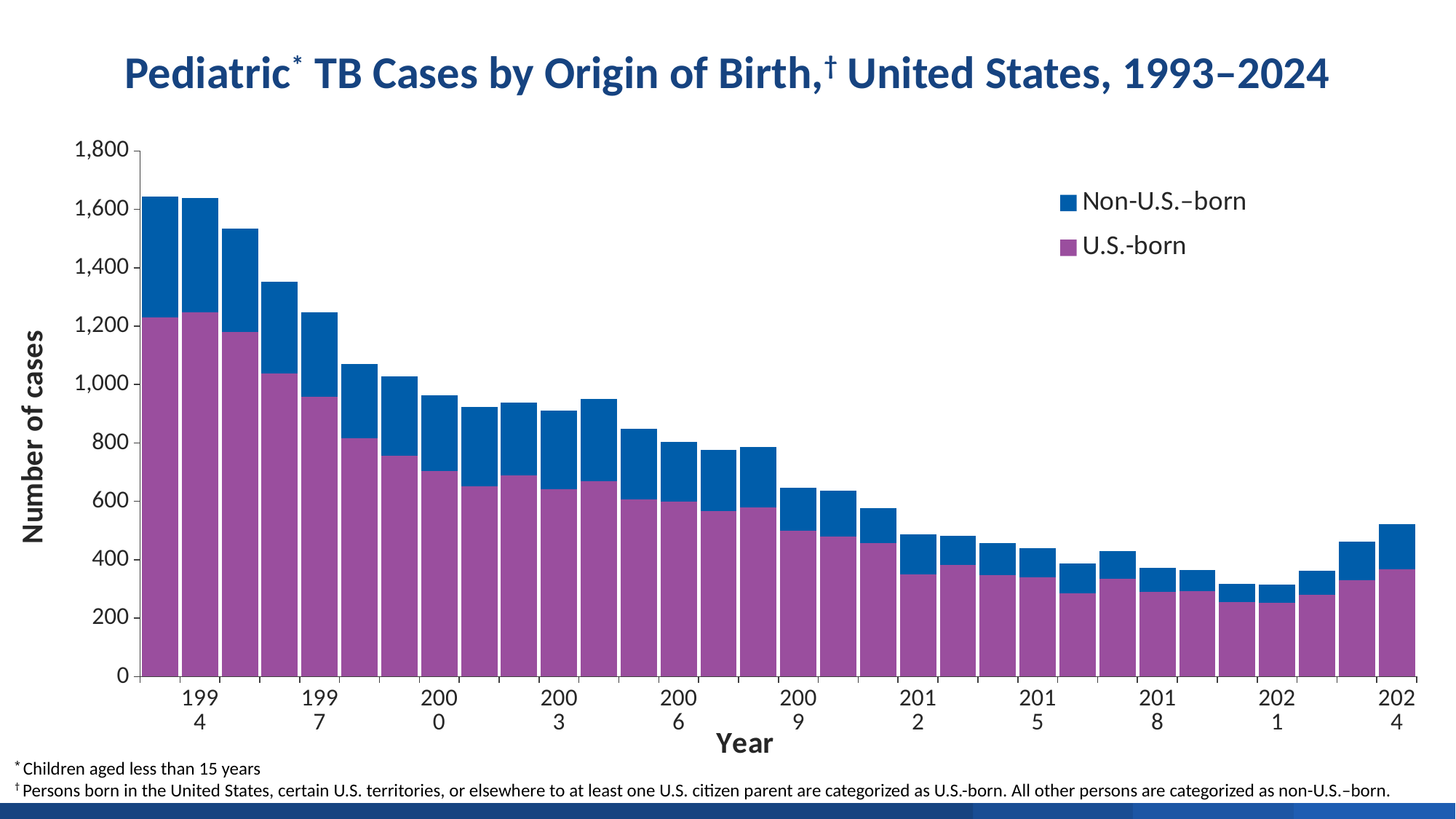
How many series does the legend list? 2 Is the total number of pediatric TB cases in 2021 greater or less than 400? less What colour represents U.S.-born cases in the chart? Purple How many years (bars) are plotted in the chart? 32 Is the number of U.S.-born pediatric TB cases in 2024 greater or less than 400? less Is the total number of pediatric TB cases in 2024 greater or less than 400? greater Do total pediatric TB cases generally rise or fall from 1993 to 2021? fall What kind of chart is shown on the slide? Stacked bar chart Which year has the larger total number of pediatric TB cases, 2021 or 2024? 2024 Which year has the larger total number of pediatric TB cases, 1997 or 2000? 1997